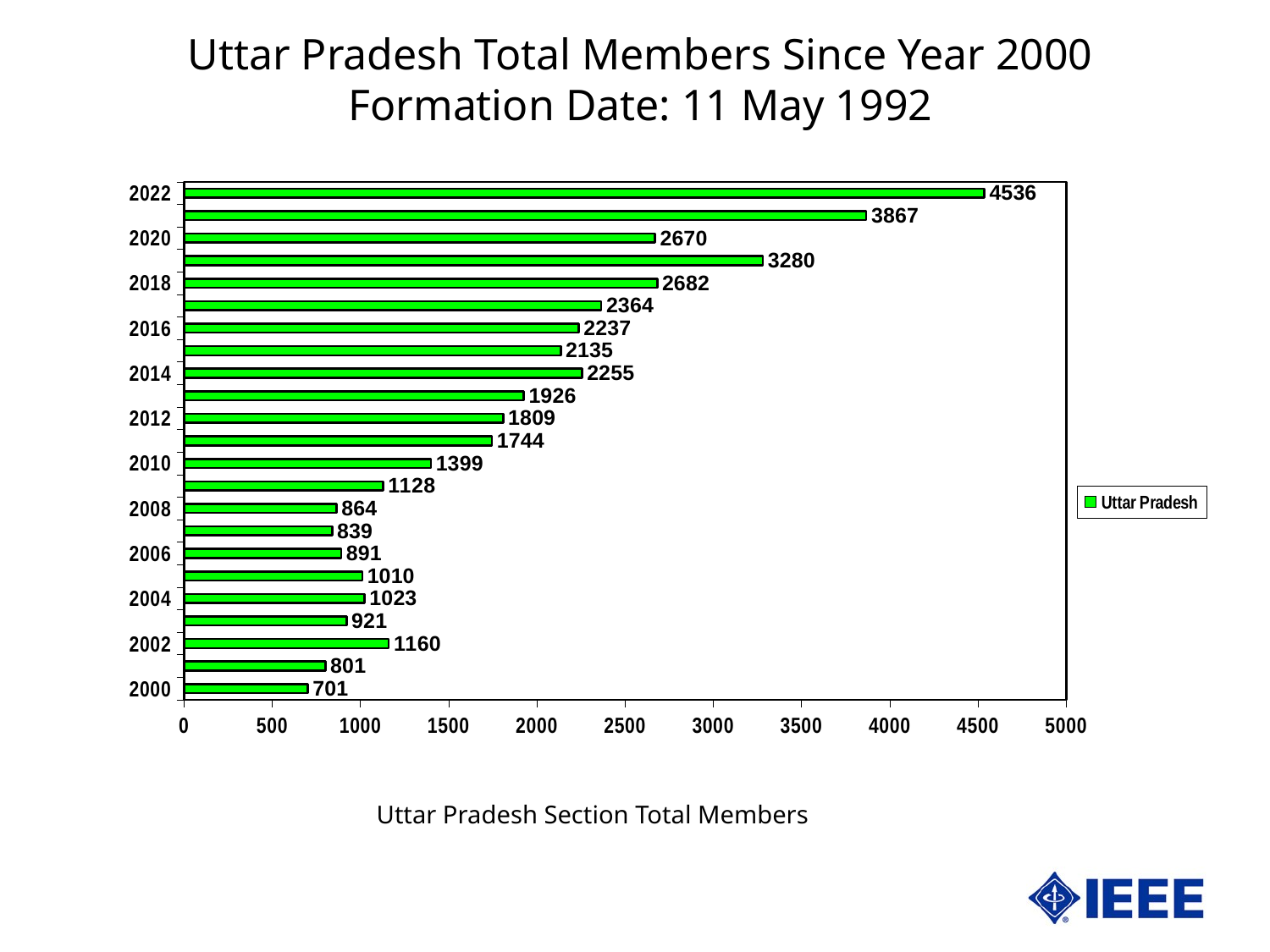
What is the difference between the values for 2022 and 2020? 1866 Is the value for 2014 greater or less than 2000? greater Which year has the lowest value? 2000 Which is larger, the value for 2018 or the value for 2020? 2018 How many series does the legend list? 1 What kind of chart is shown? bar chart What is the value for 2022? 4536 What is the value for 2016? 2237 What is the value for 2010? 1399 What is the title of the chart? Uttar Pradesh Total Members Since Year 2000 Formation Date: 11 May 1992 What is the value for 2000? 701 Which year has the highest value? 2022